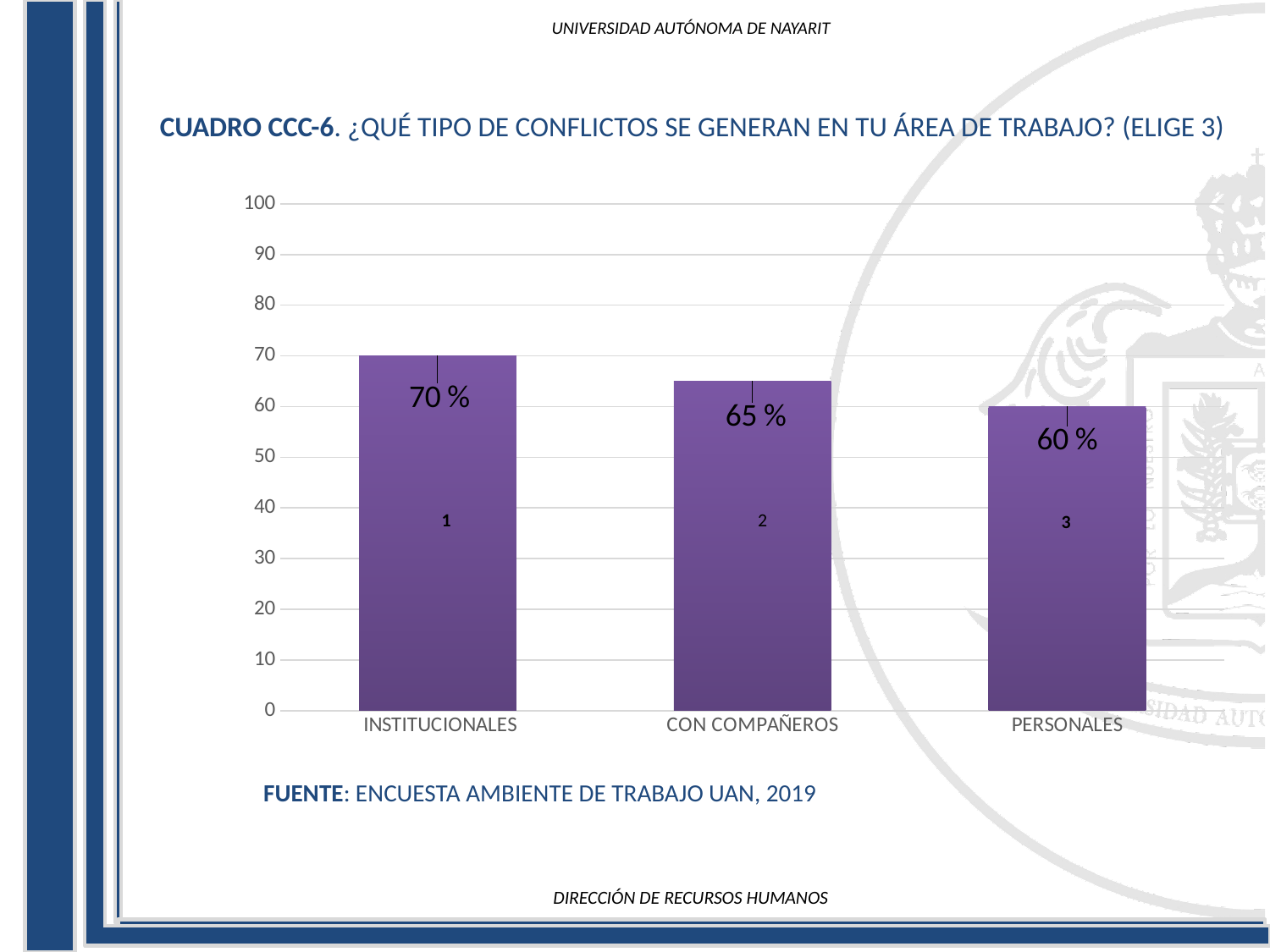
What kind of chart is shown on the slide? bar chart Do the values rise or fall from left to right along the x axis? fall Is the value for CON COMPAÑEROS greater or less than 50? greater Which is larger, the value for CON COMPAÑEROS or the value for PERSONALES? CON COMPAÑEROS Which category has the lowest value? PERSONALES What is the difference between the values for INSTITUCIONALES and PERSONALES? 10 % What is the value for INSTITUCIONALES? 70 % Which category has the highest value? INSTITUCIONALES What is the value for PERSONALES? 60 % How many categories are shown on the x axis? 3 What is the difference between the values for CON COMPAÑEROS and PERSONALES? 5 % What is the value for CON COMPAÑEROS? 65 %